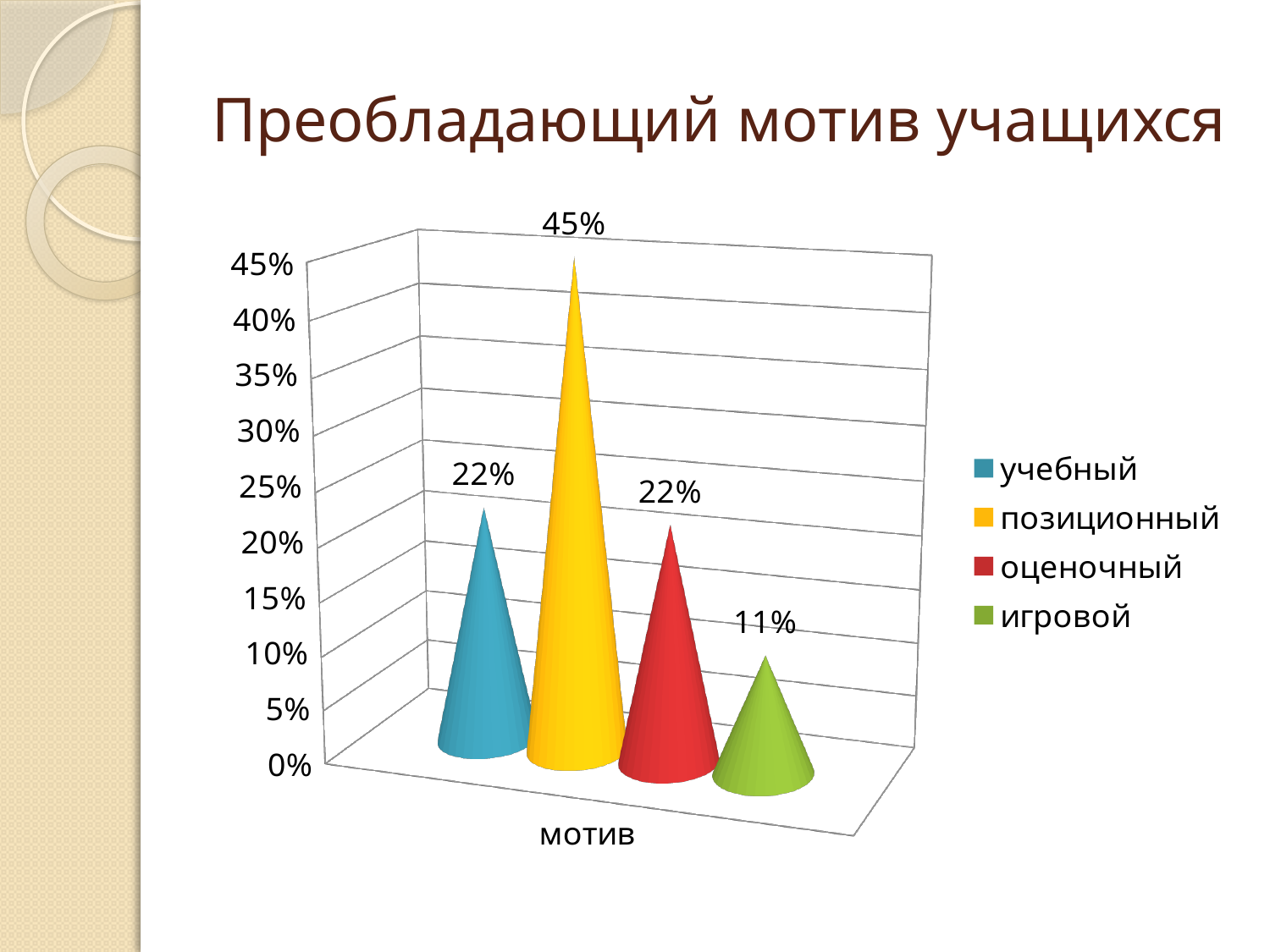
What is the value for игровой? 11% What is the value for оценочный? 22% What is the title of the slide containing the chart? Преобладающий мотив учащихся Which series has the lowest value? игровой What is the difference between the values for учебный and игровой? 11% What is the label on the x axis of the chart? мотив Which series has the highest value? позиционный How many series does the legend list? 4 What is the difference between the values for позиционный and игровой? 34% What is the value for учебный? 22% What is the value for позиционный? 45% Which is larger, the value for позиционный or the value for оценочный? позиционный